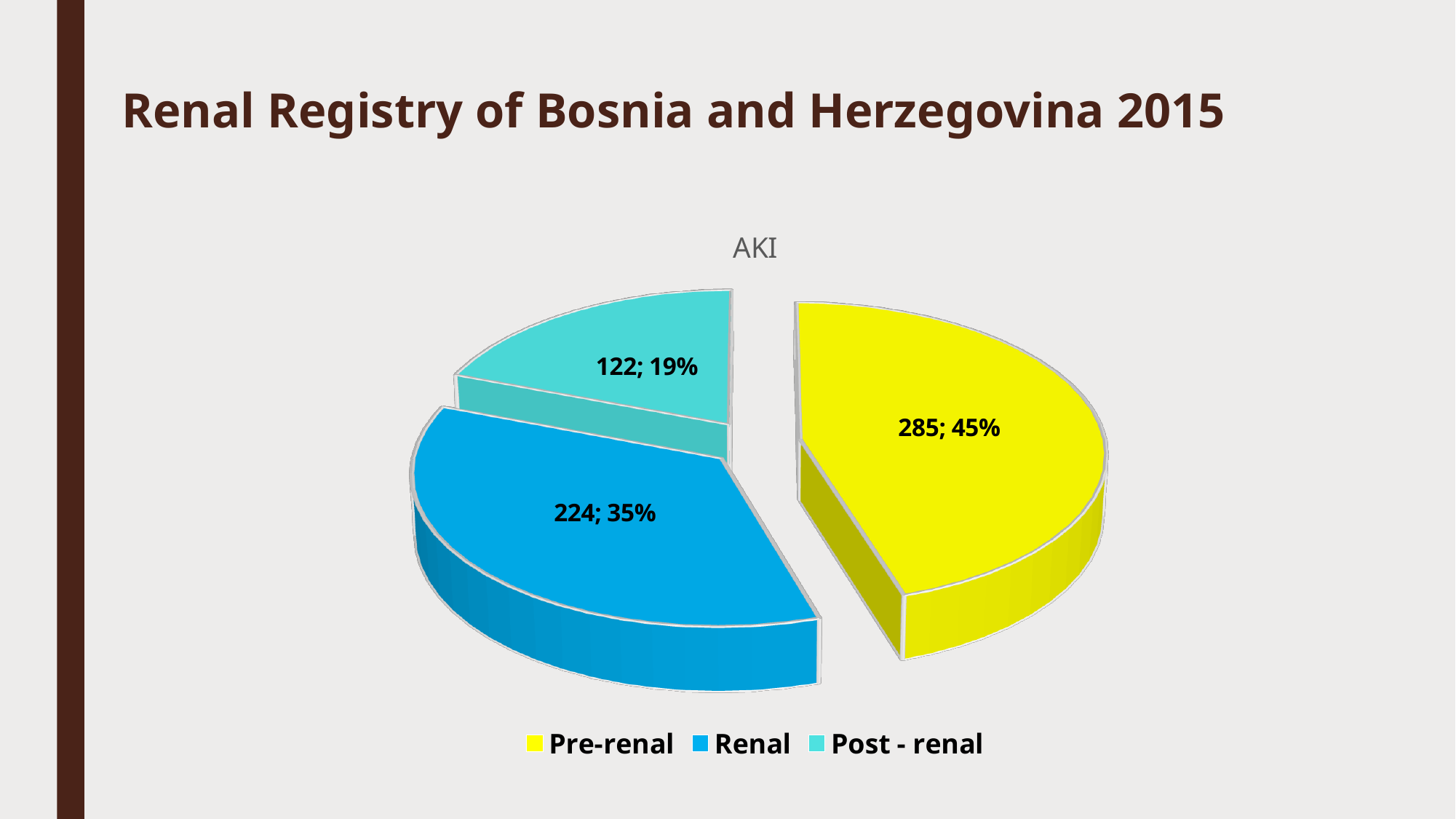
What colour is the Renal slice in the AKI pie chart? Blue Which is larger in the AKI pie chart, Renal or Post - renal? Renal How many categories are shown in the AKI pie chart? 3 What is the difference between the Pre-renal and Renal values in the AKI pie chart? 61 Which category has the smallest slice in the AKI pie chart? Post - renal What share of the AKI pie does Pre-renal represent? 45% What is the value for Renal in the AKI pie chart? 224 What is the value for Post - renal in the AKI pie chart? 122 What kind of chart is shown on the slide? Pie chart What is the value for Pre-renal in the AKI pie chart? 285 What share of the AKI pie does Post - renal represent? 19% Which category has the largest slice in the AKI pie chart? Pre-renal